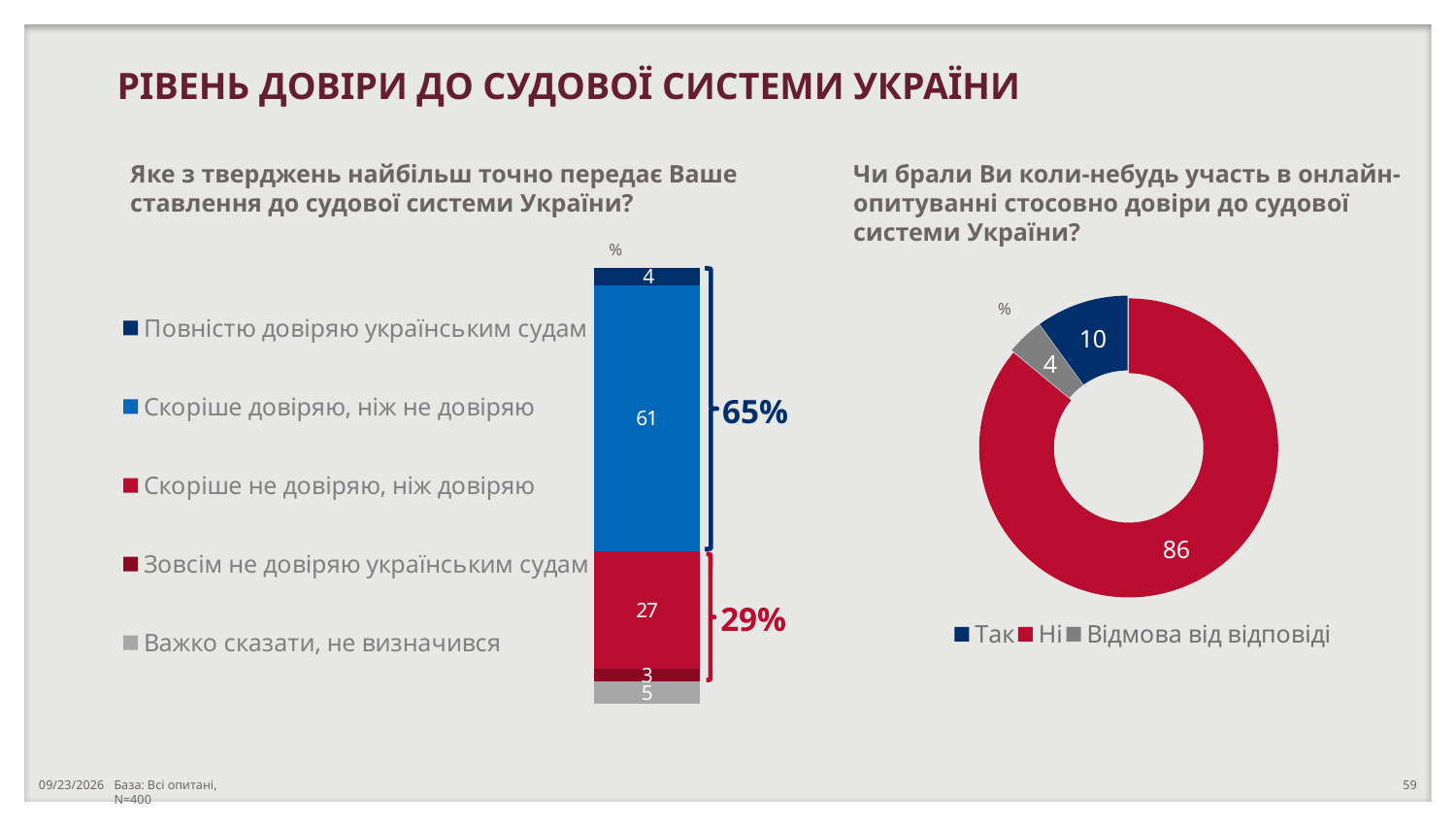
On the right doughnut chart, which is larger, "Так" or "Відмова від відповіді"? Так On the left stacked bar chart, what is the value for "Скоріше не довіряю, ніж довіряю"? 27 On the left stacked bar chart, which category has the smallest value? Зовсім не довіряю українським судам On the left stacked bar chart, what is the total of all segments in the bar? 100 What type of chart is shown on the right side of the slide? Doughnut chart On the right doughnut chart, what is the value for "Ні"? 86 On the left stacked bar chart, what is the value for "Скоріше довіряю, ніж не довіряю"? 61 On the left stacked bar chart, what combined percentage is shown by the bracket for the two "довіряю" segments? 65% On the left stacked bar chart, what is the difference between "Скоріше довіряю, ніж не довіряю" and "Скоріше не довіряю, ніж довіряю"? 34 On the left stacked bar chart, which category has the largest value? Скоріше довіряю, ніж не довіряю How many entries does the legend of the left stacked bar chart list? 5 On the left stacked bar chart, what is the value for "Важко сказати, не визначився"? 5